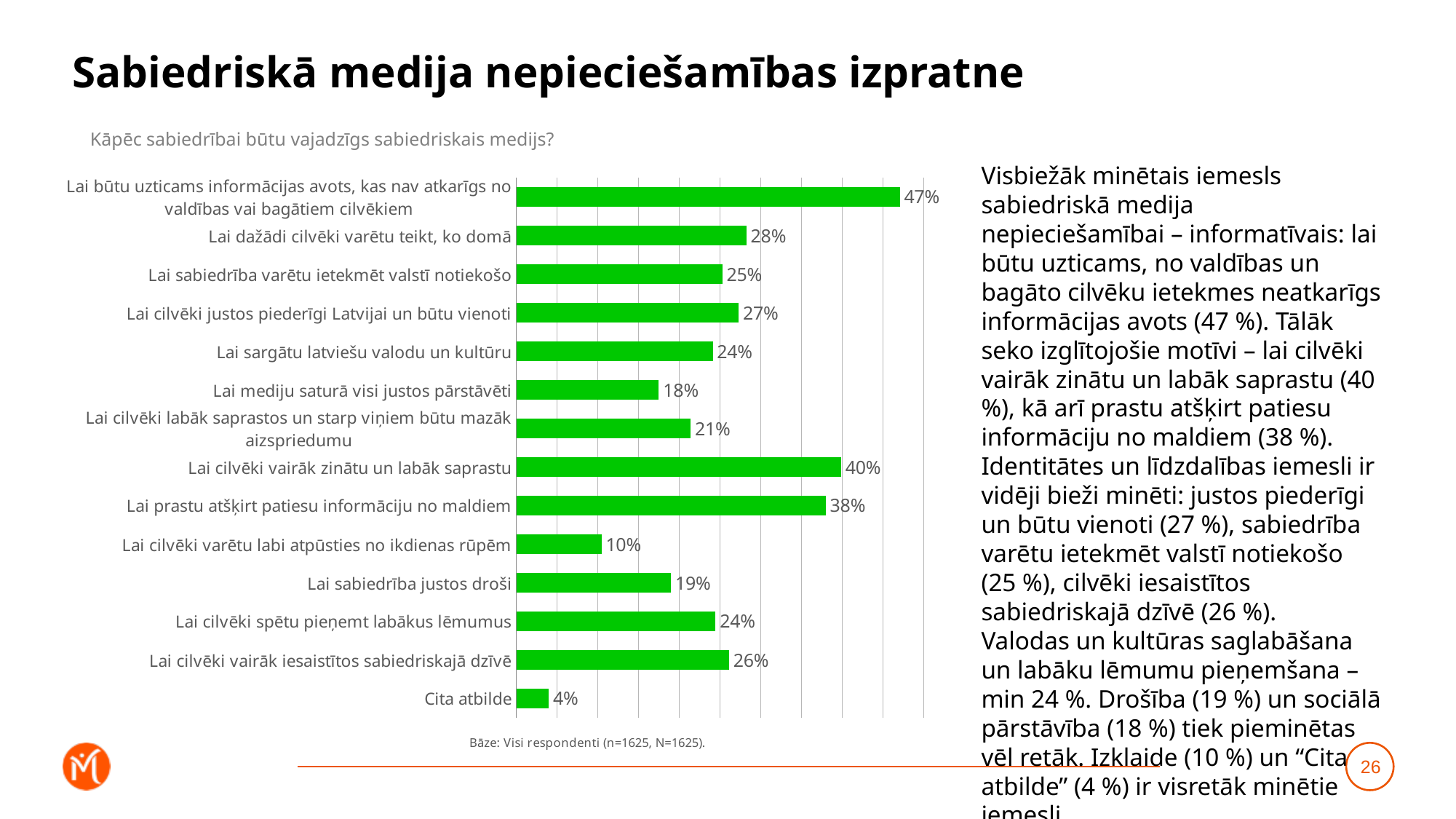
What question is shown as the chart's title? Kāpēc sabiedrībai būtu vajadzīgs sabiedriskais medijs? Which category has the highest value? Lai būtu uzticams informācijas avots, kas nav atkarīgs no valdības vai bagātiem cilvēkiem What is the difference between "Lai cilvēki vairāk zinātu un labāk saprastu" and "Lai prastu atšķirt patiesu informāciju no maldiem"? 2% What is the value for "Lai prastu atšķirt patiesu informāciju no maldiem"? 38% Which is larger: "Lai cilvēki justos piederīgi Latvijai un būtu vienoti" or "Lai sabiedrība varētu ietekmēt valstī notiekošo"? Lai cilvēki justos piederīgi Latvijai un būtu vienoti How many categories are shown in the chart? 14 What is the value for "Lai būtu uzticams informācijas avots, kas nav atkarīgs no valdības vai bagātiem cilvēkiem"? 47% What is the difference between "Lai dažādi cilvēki varētu teikt, ko domā" and "Lai mediju saturā visi justos pārstāvēti"? 10% What kind of chart is shown on the slide? Bar chart Which category has the lowest value? Cita atbilde What is the value for "Lai cilvēki varētu labi atpūsties no ikdienas rūpēm"? 10% What is the value for "Lai sabiedrība justos droši"? 19%